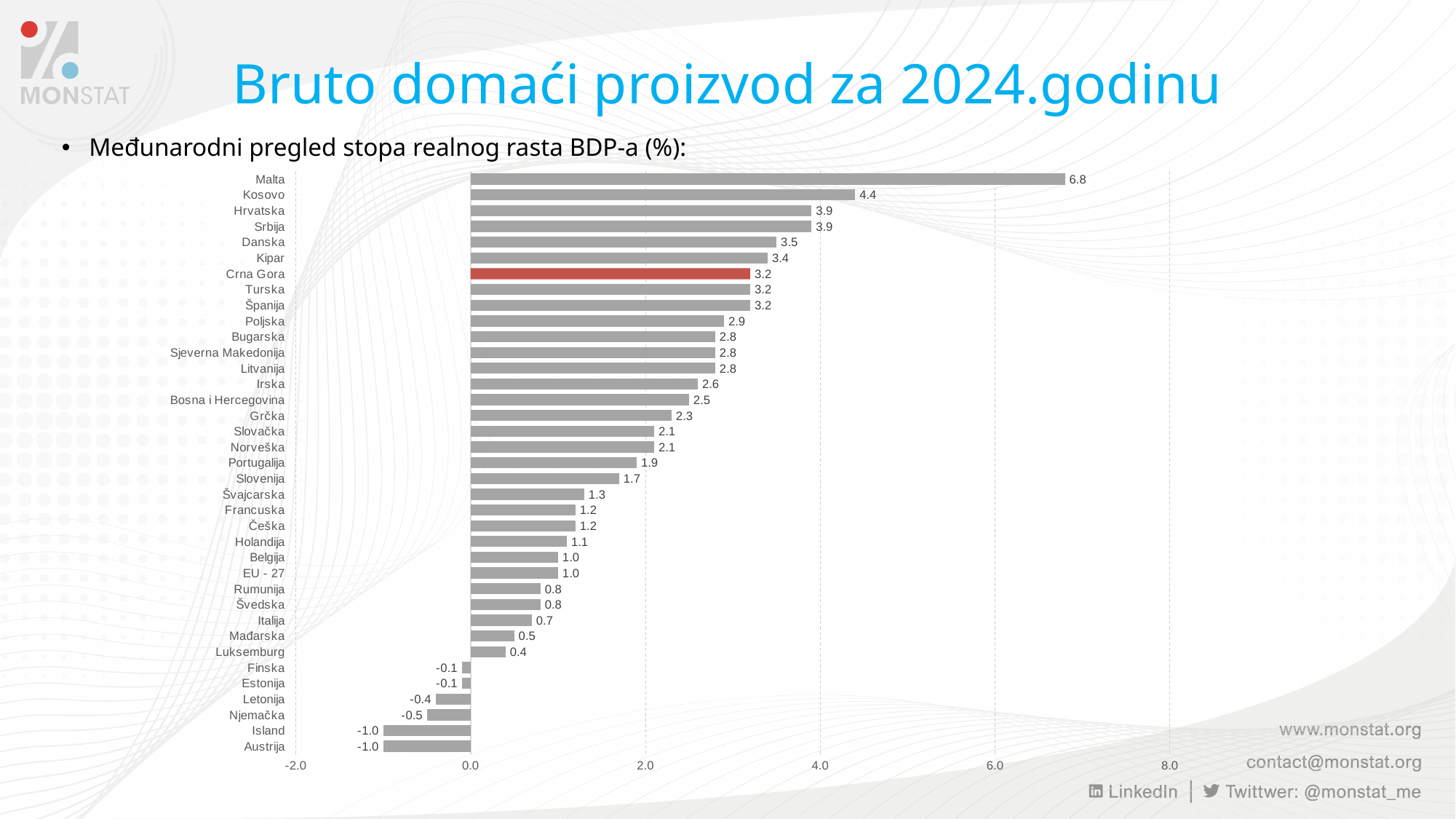
Which bar is highlighted in red on the chart? Crna Gora What is the value for EU - 27? 1.0 What is the difference between the values for Crna Gora and Srbija? 0.7 What is the value for Kosovo? 4.4 What is the difference between the values for Malta and Kosovo? 2.4 Which country has the highest value on the chart? Malta Which has a larger value, Danska or Grčka? Danska What is the value for Crna Gora? 3.2 How many countries or regions are shown on the chart? 37 Which has a larger value, Italija or Slovenija? Slovenija What is the value for Njemačka? -0.5 What kind of chart is shown on the slide? Bar chart